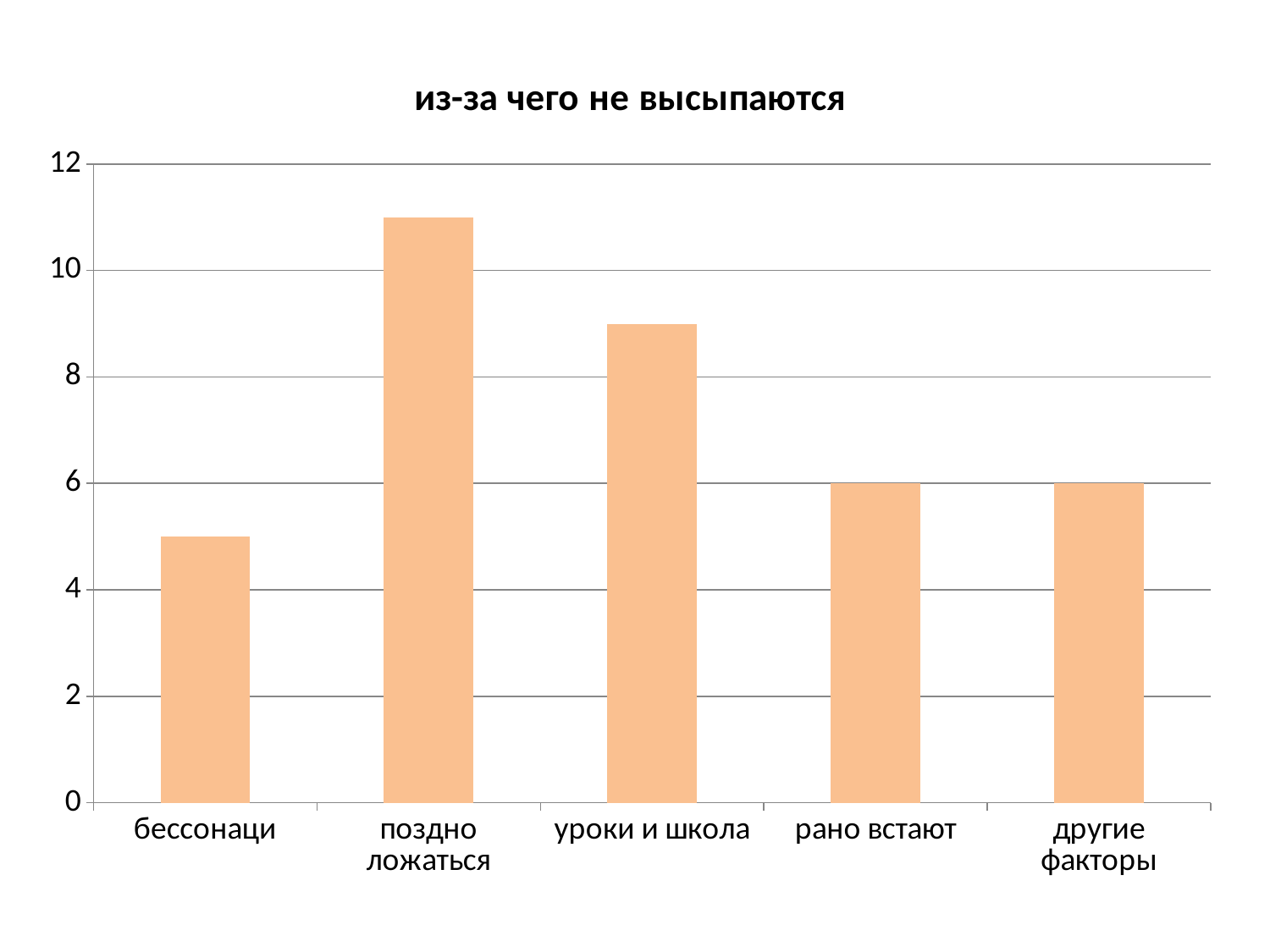
Is the value for уроки и школа greater or less than 8? greater Which is larger, the value for поздно ложаться or the value for уроки и школа? поздно ложаться What is the value for рано встают? 6 What is the title of the chart? из-за чего не высыпаются Which category has the highest value? поздно ложаться Which category has the lowest value? бессонаци Is the value for поздно ложаться greater or less than 10? greater Is the value for бессонаци greater or less than 6? less What is the value for другие факторы? 6 What is the difference between the values for рано встают and другие факторы? 0 What kind of chart is shown on the slide? bar chart How many categories are shown on the x axis? 5